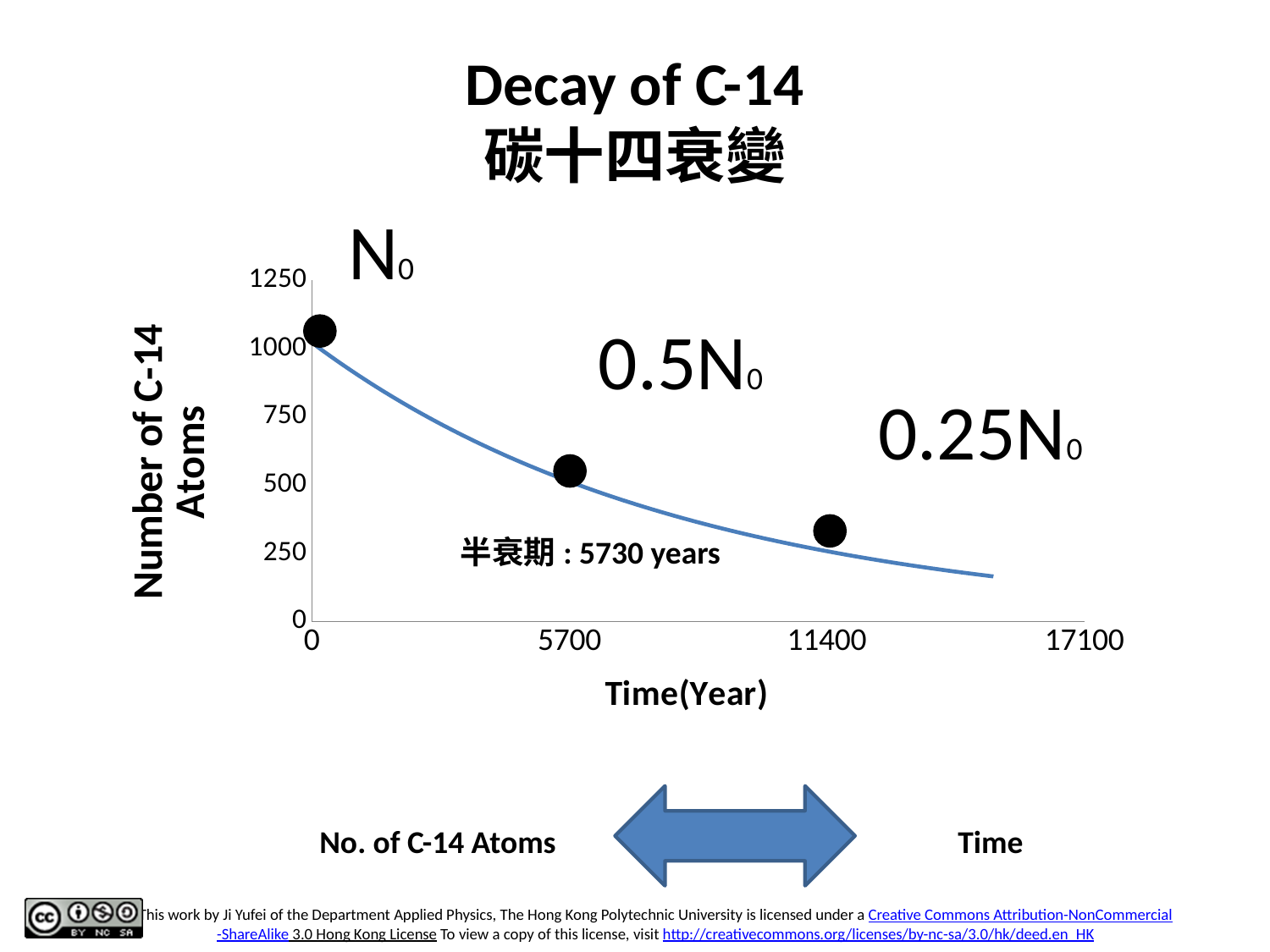
At which time (year) is the number of C-14 atoms highest? 0 Is the value at time 5700 greater or less than 750? less Is the value at time 5700 greater or less than 250? greater Do the values rise or fall as time increases along the x axis? fall What is the title of the chart's x axis? Time(Year) What kind of chart is shown on the slide? line chart What half-life value is annotated on the chart? 5730 years Is the value at time 11400 greater or less than 500? less Which has a larger number of C-14 atoms, time 0 or time 11400? 0